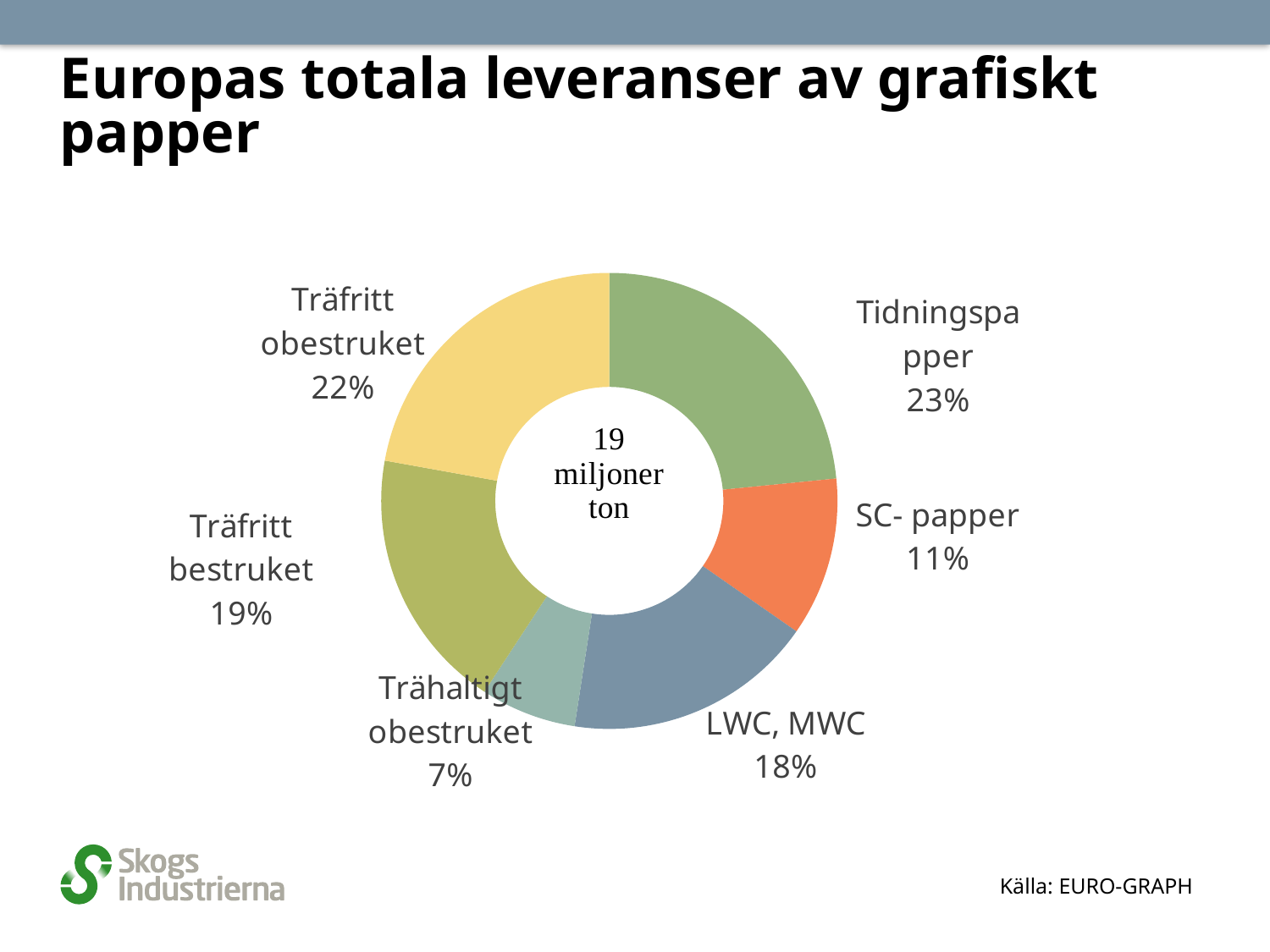
What share of the pie does Träfritt obestruket represent? 22% Which category has the smallest share of the pie? Trähaltigt obestruket What is the difference in percentage points between Träfritt bestruket and Trähaltigt obestruket? 12 What total is printed in the centre of the chart? 19 miljoner ton What share of the pie does SC- papper represent? 11% What share of the pie does Tidningspapper represent? 23% Which is larger, the share for LWC, MWC or the share for SC- papper? LWC, MWC Which category has the largest share of the pie? Tidningspapper How many categories are shown in the chart? 6 What kind of chart is shown on the slide? Pie chart (doughnut)